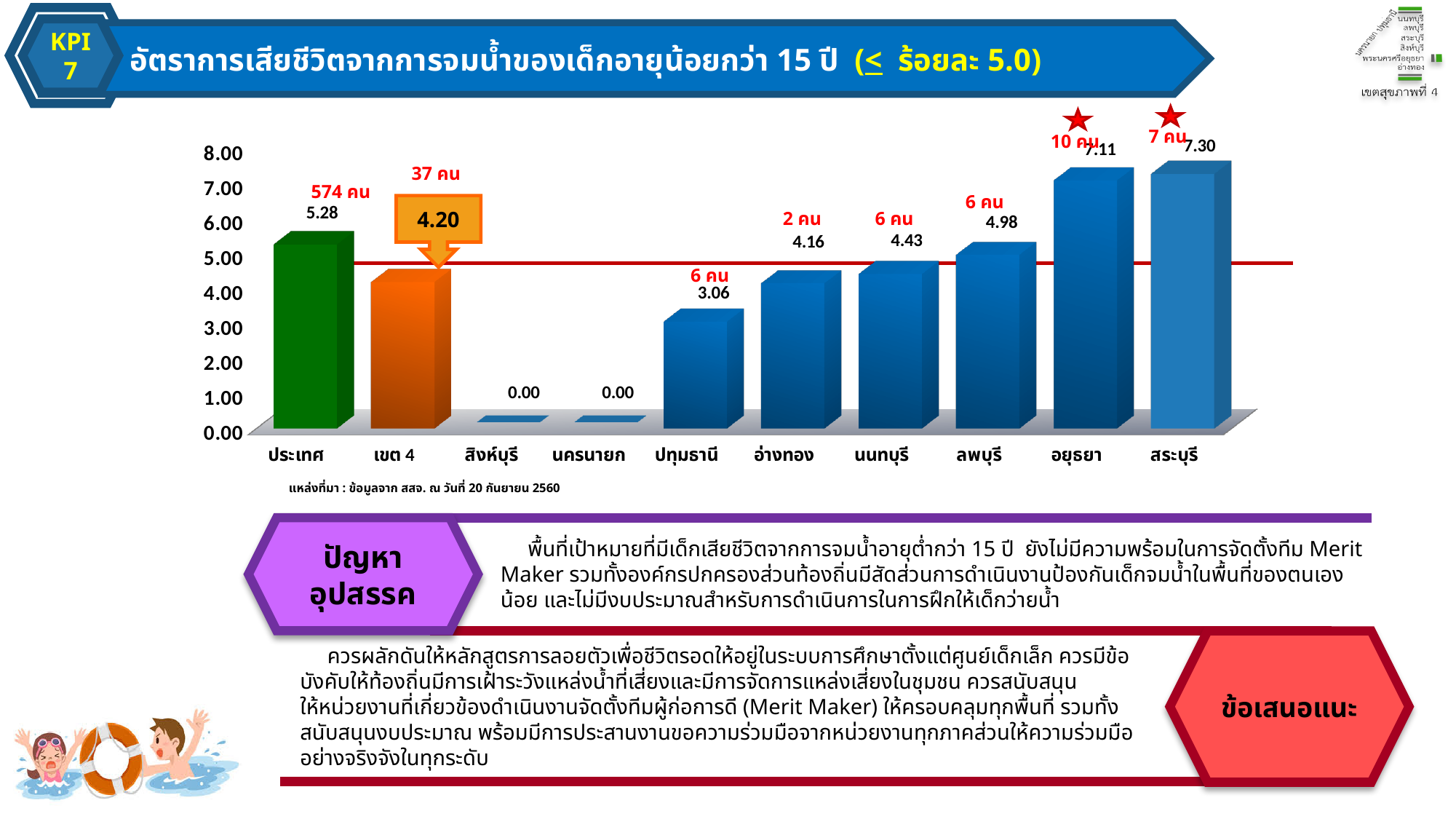
Is the value for อยุธยา greater or less than 5.00? greater What is the value for เขต 4? 4.20 What kind of chart is shown on the slide? bar chart What is the value for ประเทศ? 5.28 Which category has the highest value? สระบุรี Which is larger, the value for นนทบุรี or the value for อ่างทอง? นนทบุรี What is the value for ลพบุรี? 4.98 What is the difference between the values for ประเทศ and เขต 4? 1.08 What is the value for ปทุมธานี? 3.06 What is the difference between the values for สระบุรี and อยุธยา? 0.19 How many categories are shown on the x axis? 10 Which categories have the lowest value? สิงห์บุรี and นครนายก